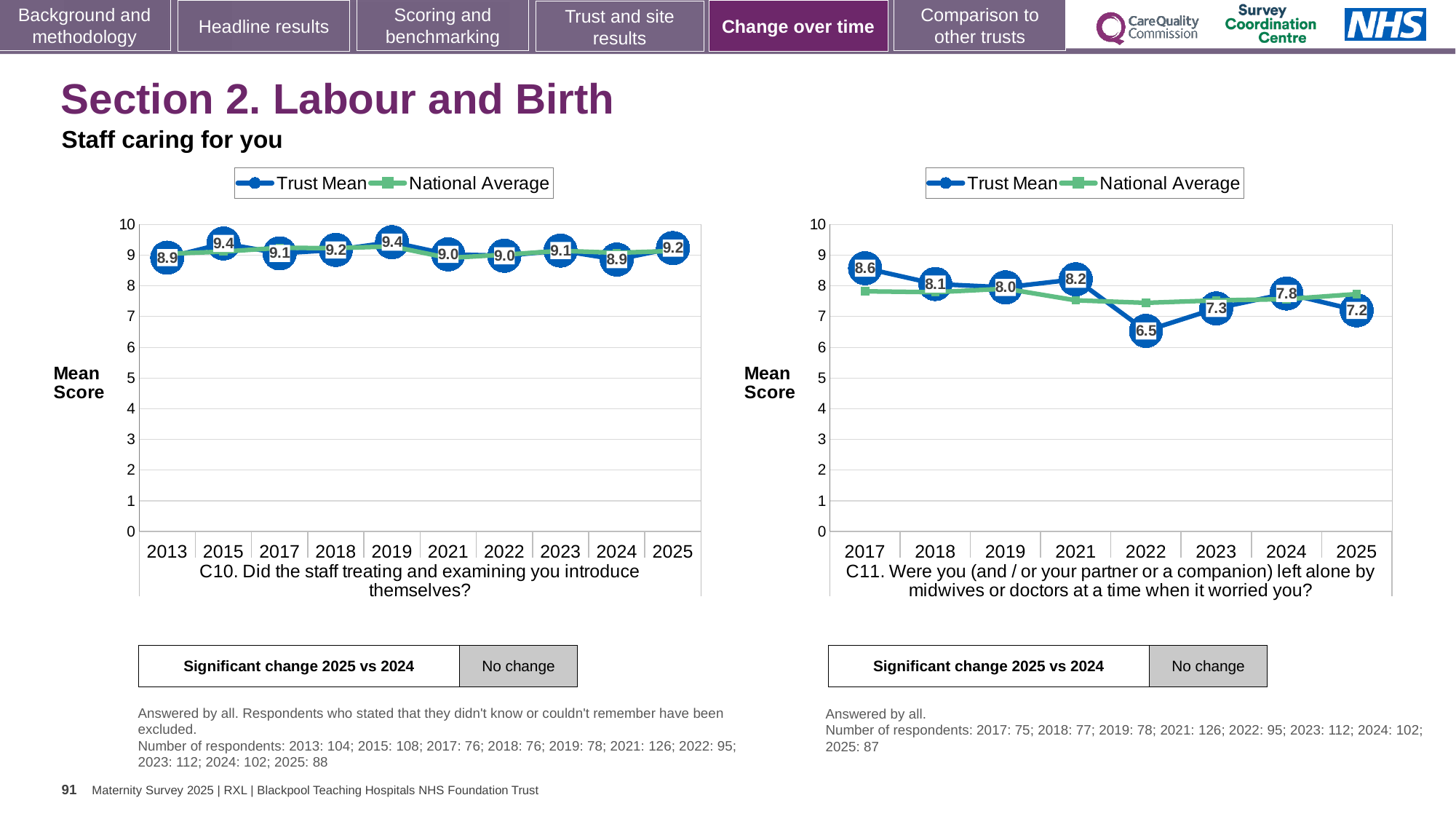
On the C10 chart (left), how many years are plotted on the x axis? 10 On the C11 chart (right), what is the Trust Mean score for 2022? 6.5 On the C11 chart (right), what is the difference between the Trust Mean scores for 2024 and 2025? 0.6 On the C11 chart (right), which year has the highest Trust Mean score? 2017 On the C11 chart (right), how many series does the legend list? 2 On the C10 chart (left), what is the Trust Mean score for 2025? 9.2 On the C11 chart (right), is the National Average for 2022 greater or less than 8? less On the C10 chart (left), is the Trust Mean score for 2019 higher or lower than for 2024? higher On the C10 chart (left), what is the Trust Mean score for 2013? 8.9 On the C11 chart (right), which year has the lowest Trust Mean score? 2022 On the C11 chart (right), what is the Trust Mean score for 2017? 8.6 What type of chart is the C10 chart on the left? line chart